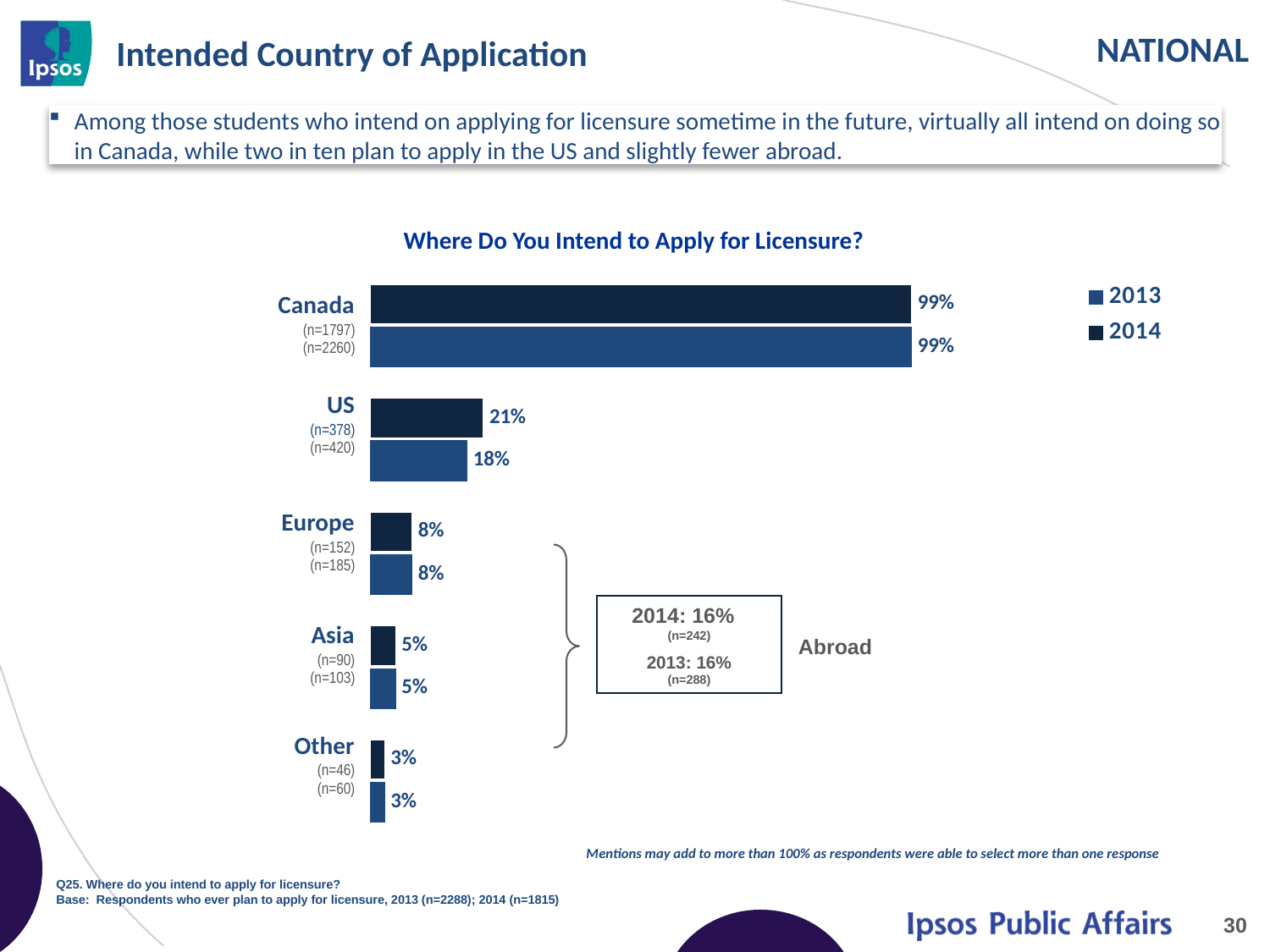
Which category has the lowest value in 2013? Other What is the difference between the 2013 and 2014 values for US? 3% What is the 2014 value for US? 21% Which is larger for US: the 2013 value or the 2014 value? 2014 What is the 2013 value for US in the chart 'Where Do You Intend to Apply for Licensure?' 18% What is the 2014 value for Other? 3% How many categories are shown in the chart? 5 What is the 2014 value for Canada? 99% How many series does the legend list? 2 What kind of chart is shown on the slide? Bar chart What is the 2013 value for Europe? 8% Which category has the highest value in 2014? Canada